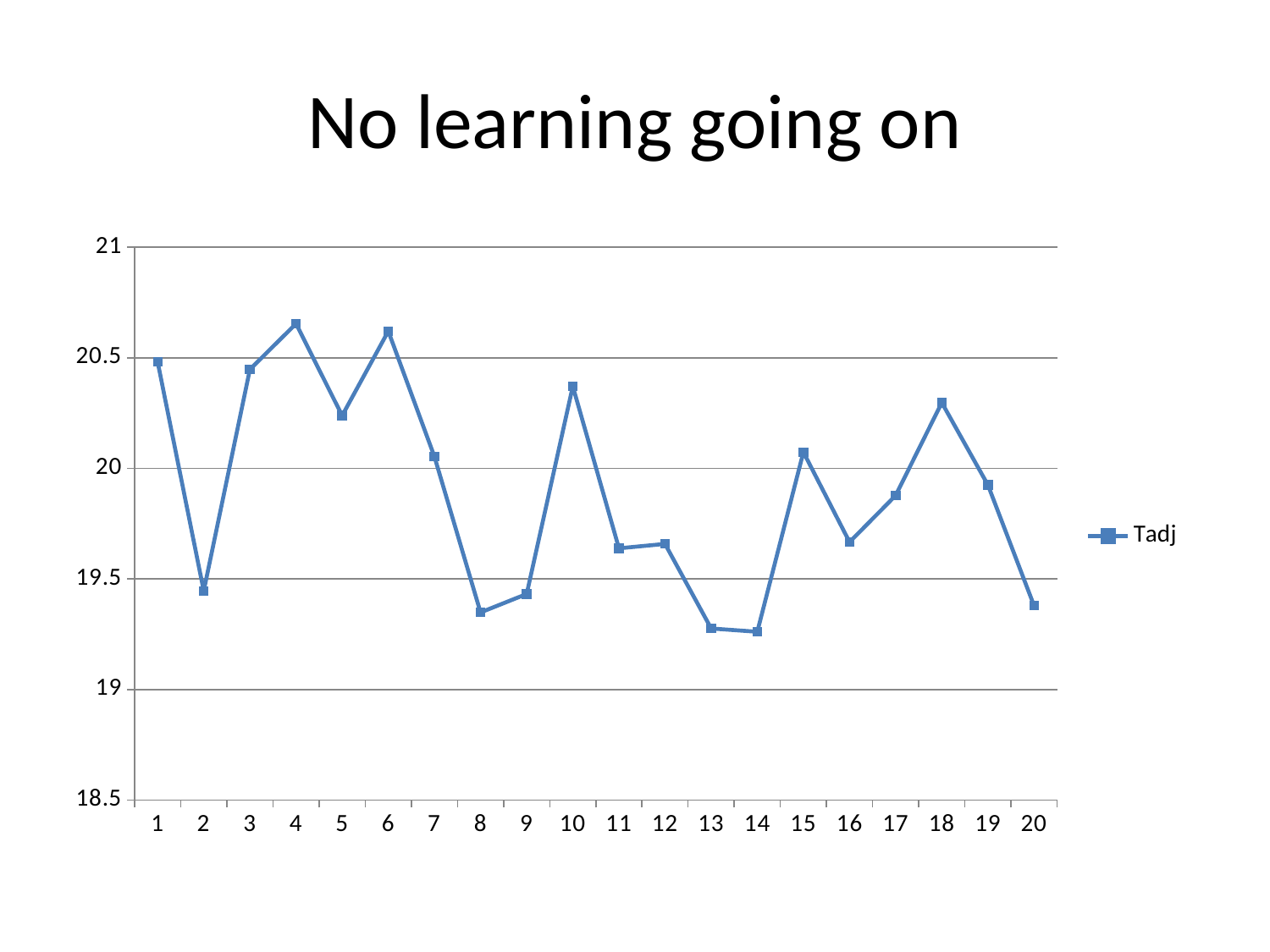
Which has the larger Tadj value, point 4 or point 2? point 4 What kind of chart is shown on the slide? line chart What is the name of the series shown in the legend? Tadj Is the value for Tadj at point 8 greater or less than 19.5? less Is the value for Tadj at point 5 greater or less than 20.5? less Does the Tadj value rise or fall from point 7 to point 8? fall What is the title of the chart slide? No learning going on Is the value for Tadj at point 11 greater or less than 20? less How many series does the legend list? 1 How many data points are plotted along the x axis? 20